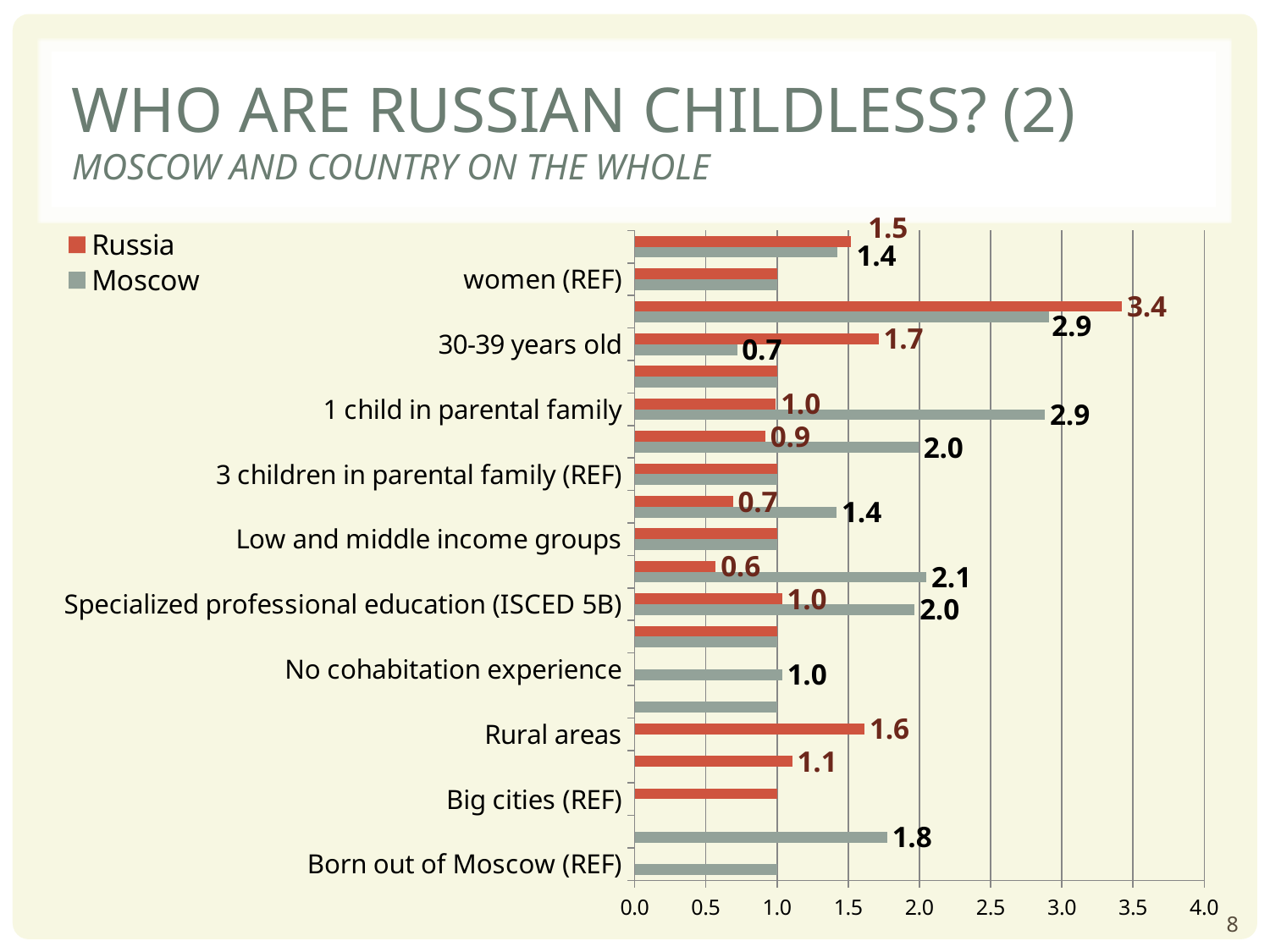
For the 30-39 years old category, which series has the larger value, Russia or Moscow? Russia What type of chart is shown on the slide? bar chart What is the Moscow value for the Specialized professional education (ISCED 5B) category? 2.0 What is the lowest labelled value shown for the Russia series? 0.6 How many series does the legend list? 2 What is the Moscow value for the 1 child in parental family category? 2.9 What is the Moscow value for the 30-39 years old category? 0.7 What is the highest value shown for the Russia series? 3.4 What are the two series named in the legend? Russia and Moscow What is the Russia value for the 30-39 years old category? 1.7 For the 30-39 years old category, what is the difference between the Russia and Moscow values? 1.0 For the 1 child in parental family category, what is the difference between the Moscow and Russia values? 1.9